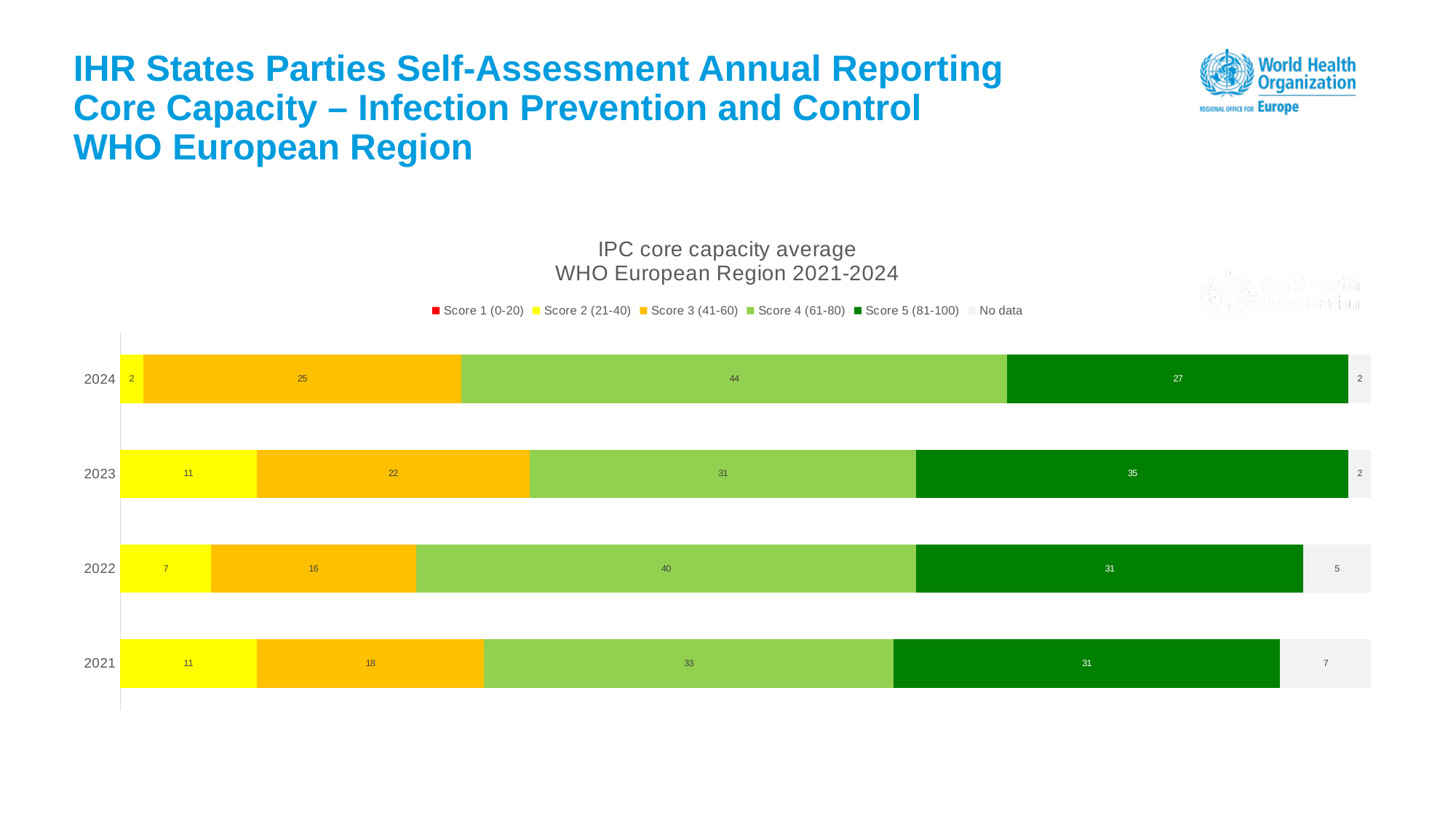
What is the total of the stacked bar for 2024? 100 What is the value for Score 5 (81-100) in 2023? 35 What is the No data value for 2021? 7 How many series does the legend list? 6 Which year has the larger Score 5 (81-100) value, 2023 or 2022? 2023 What is the value for Score 4 (61-80) in 2024? 44 Which year has the highest value for Score 4 (61-80)? 2024 What is the difference between the Score 3 (41-60) values for 2024 and 2021? 7 What kind of chart is shown on the slide? Stacked bar chart How many years are shown on the chart? 4 Which year has the lowest value for Score 2 (21-40)? 2024 What is the title of the chart? IPC core capacity average WHO European Region 2021-2024